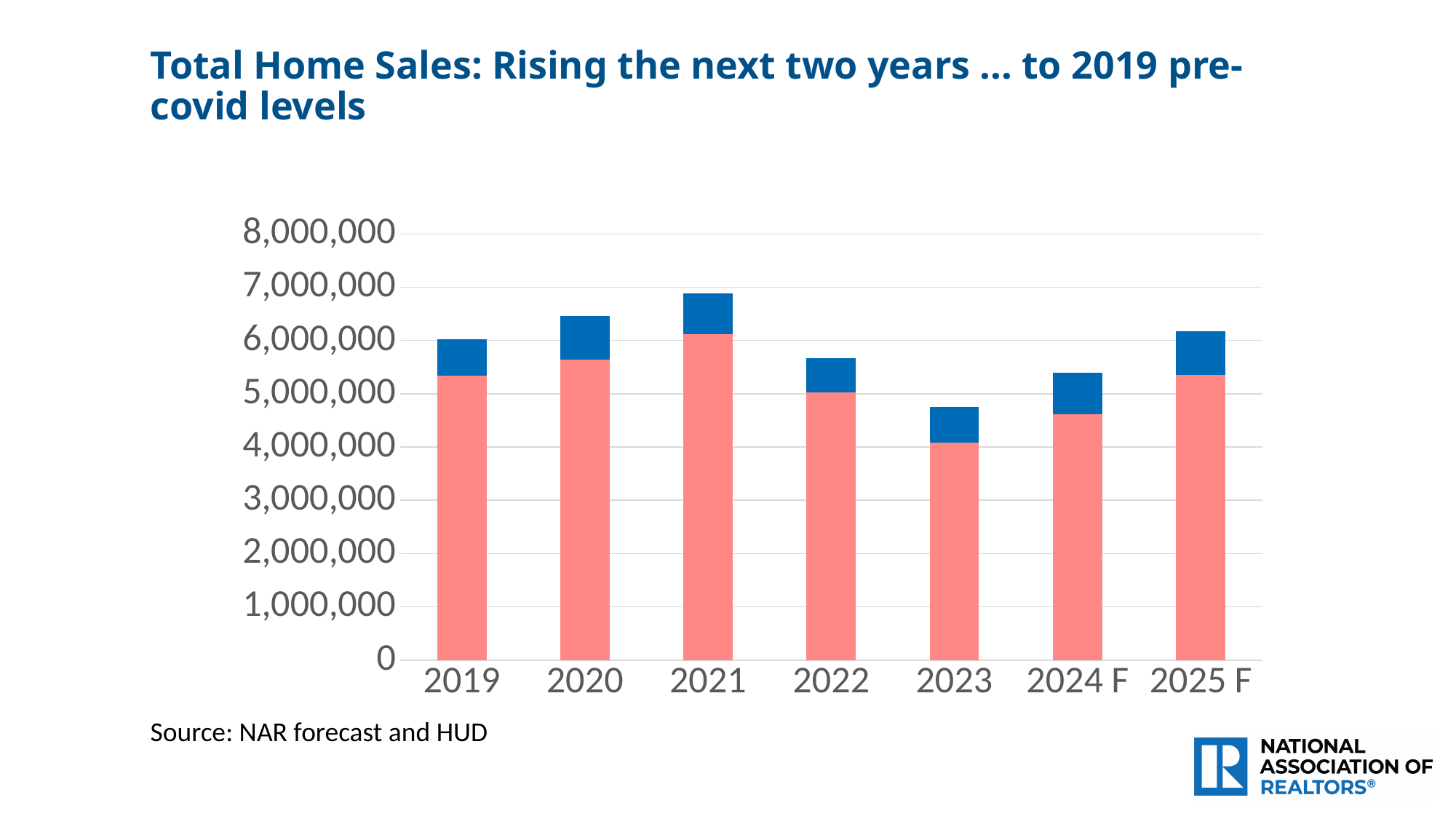
Which year has the highest total home sales bar? 2021 How many years (categories) are shown on the x axis? 7 Is the total bar for 2020 greater or less than 6,000,000? greater Which bar is taller, 2020 or 2022? 2020 Is the total bar for 2022 greater or less than 5,000,000? greater Which bar is taller, 2024 F or 2025 F? 2025 F Is the total bar for 2023 greater or less than 5,000,000? less What kind of chart is shown on the slide? Stacked bar chart What is the source cited below the chart? NAR forecast and HUD Do the total bars rise or fall from 2021 to 2023? fall Which year has the lowest total home sales bar? 2023